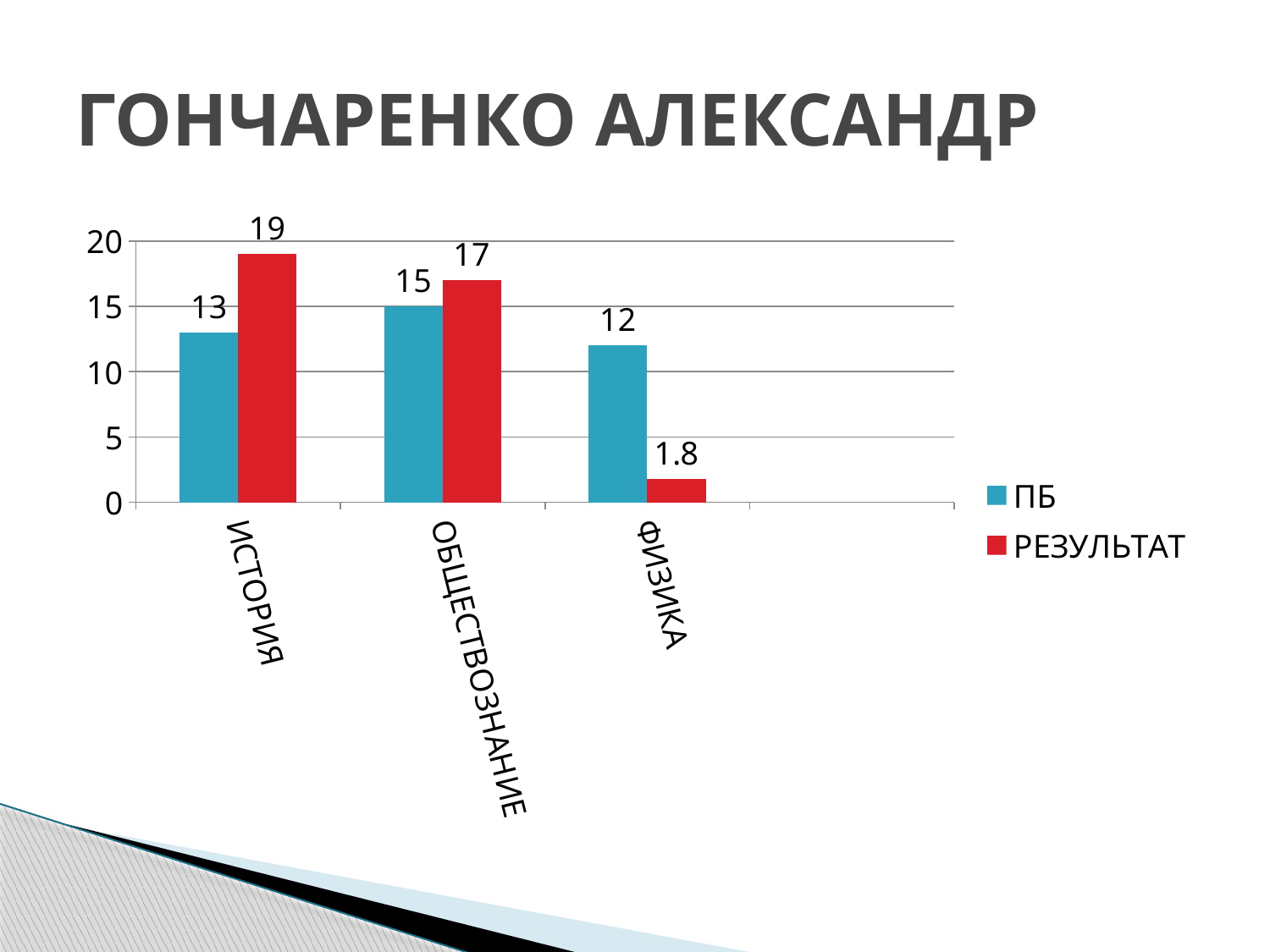
Which category has the lowest ПБ value? ФИЗИКА What is the ПБ value for ИСТОРИЯ? 13 How many categories are shown on the x axis? 3 Which is larger for ФИЗИКА, the ПБ value or the РЕЗУЛЬТАТ value? ПБ What colour are the РЕЗУЛЬТАТ bars? red What is the ПБ value for ОБЩЕСТВОЗНАНИЕ? 15 What is the РЕЗУЛЬТАТ value for ФИЗИКА? 1.8 Which category has the highest РЕЗУЛЬТАТ value? ИСТОРИЯ How many series does the legend list? 2 What is the difference between the РЕЗУЛЬТАТ and ПБ values for ИСТОРИЯ? 6 What kind of chart is shown on the slide? bar chart What is the РЕЗУЛЬТАТ value for ИСТОРИЯ? 19